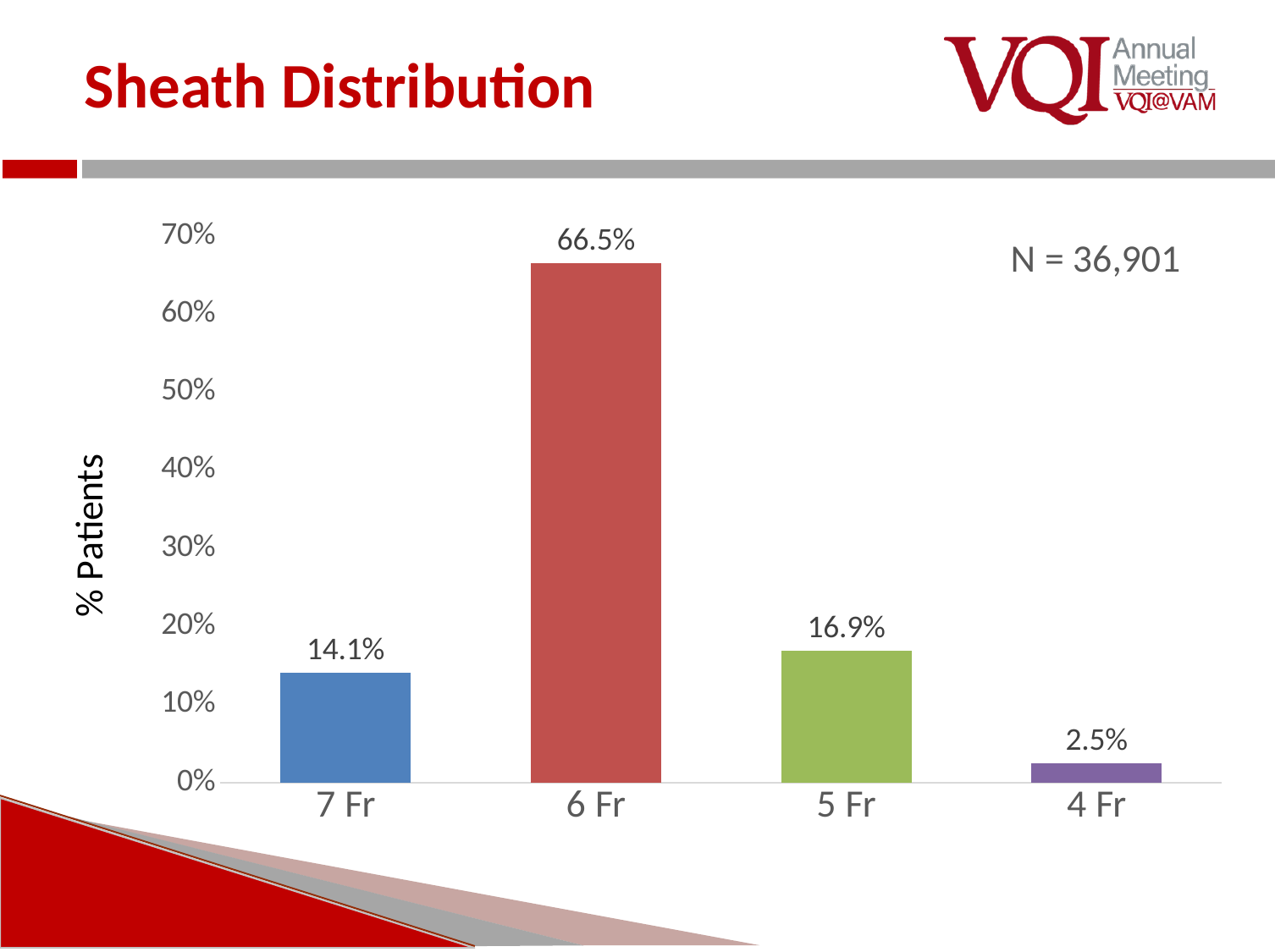
What is the difference between the values for 6 Fr and 5 Fr? 49.6% What is the value shown for 7 Fr? 14.1% What is the sample size (N) stated on the chart? N = 36,901 Which sheath size has the highest percentage of patients? 6 Fr Is the value for 6 Fr greater or less than 60%? greater Which has a larger percentage of patients, 7 Fr or 5 Fr? 5 Fr What percentage of patients had a 6 Fr sheath? 66.5% Which sheath size has the lowest percentage of patients? 4 Fr What is the difference between the values for 5 Fr and 7 Fr? 2.8% What kind of chart is shown on the slide? Bar chart How many sheath size categories are shown on the chart? 4 What percentage of patients is shown for 4 Fr? 2.5%